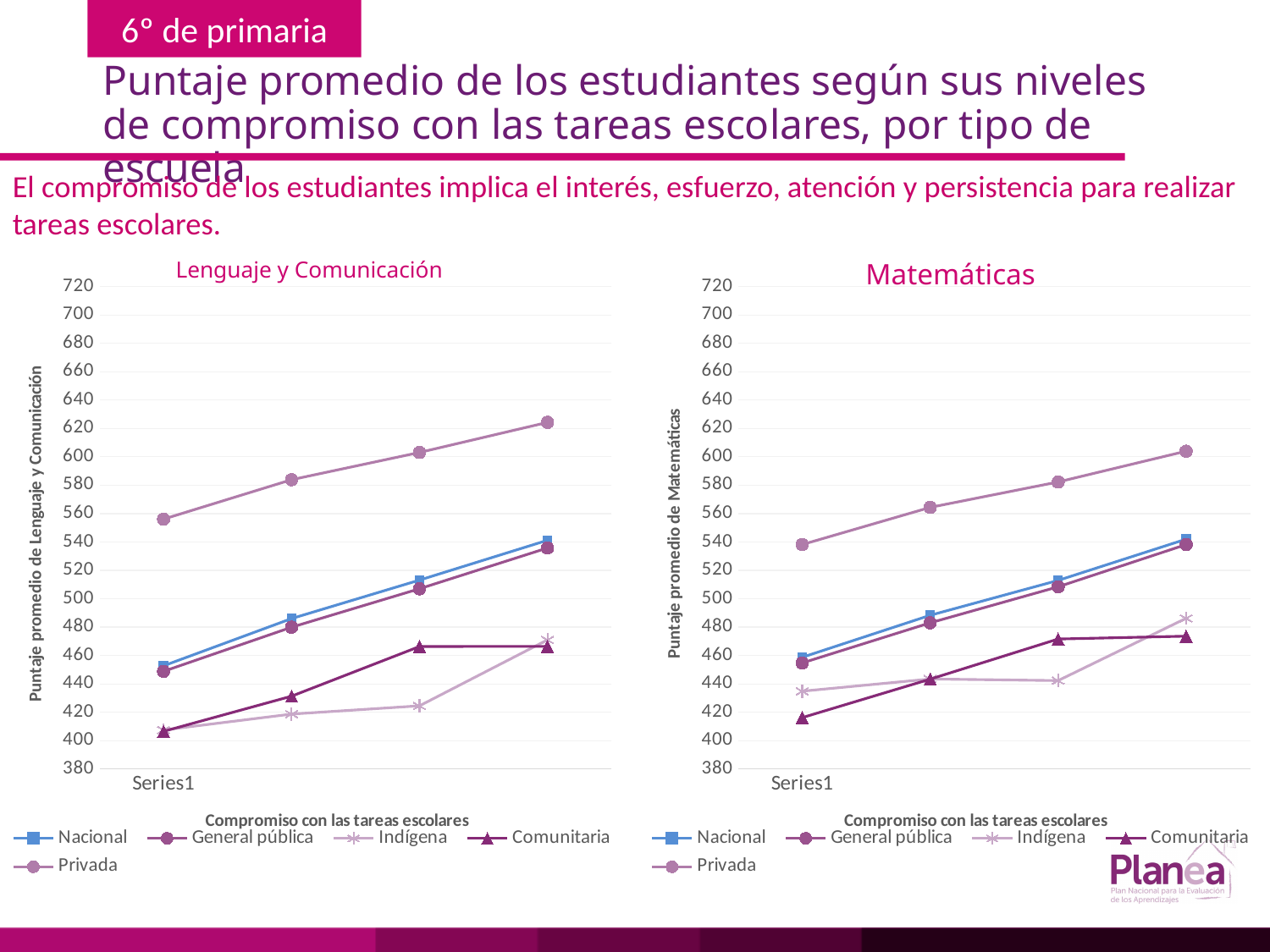
In the Lenguaje y Comunicación chart, which series has the highest values across all points? Privada In the Matemáticas chart, which series has the highest values across all points? Privada What kind of chart is the Lenguaje y Comunicación chart? line chart In the Lenguaje y Comunicación chart, at the last point, which is larger: Privada or Nacional? Privada How many points does each series have in the Matemáticas chart? 4 What is the x-axis title of the Lenguaje y Comunicación chart? Compromiso con las tareas escolares In the Lenguaje y Comunicación chart, is the last value for Privada greater or less than 600? greater In the Matemáticas chart, at the first point, which is larger: Indígena or Comunitaria? Indígena In the Matemáticas chart, which series has the lowest value at the first point? Comunitaria In the Matemáticas chart, is the first value for Comunitaria greater or less than 420? less In the Lenguaje y Comunicación chart, do the values for Nacional rise or fall along the x axis? rise How many series does the legend of the Matemáticas chart list? 5